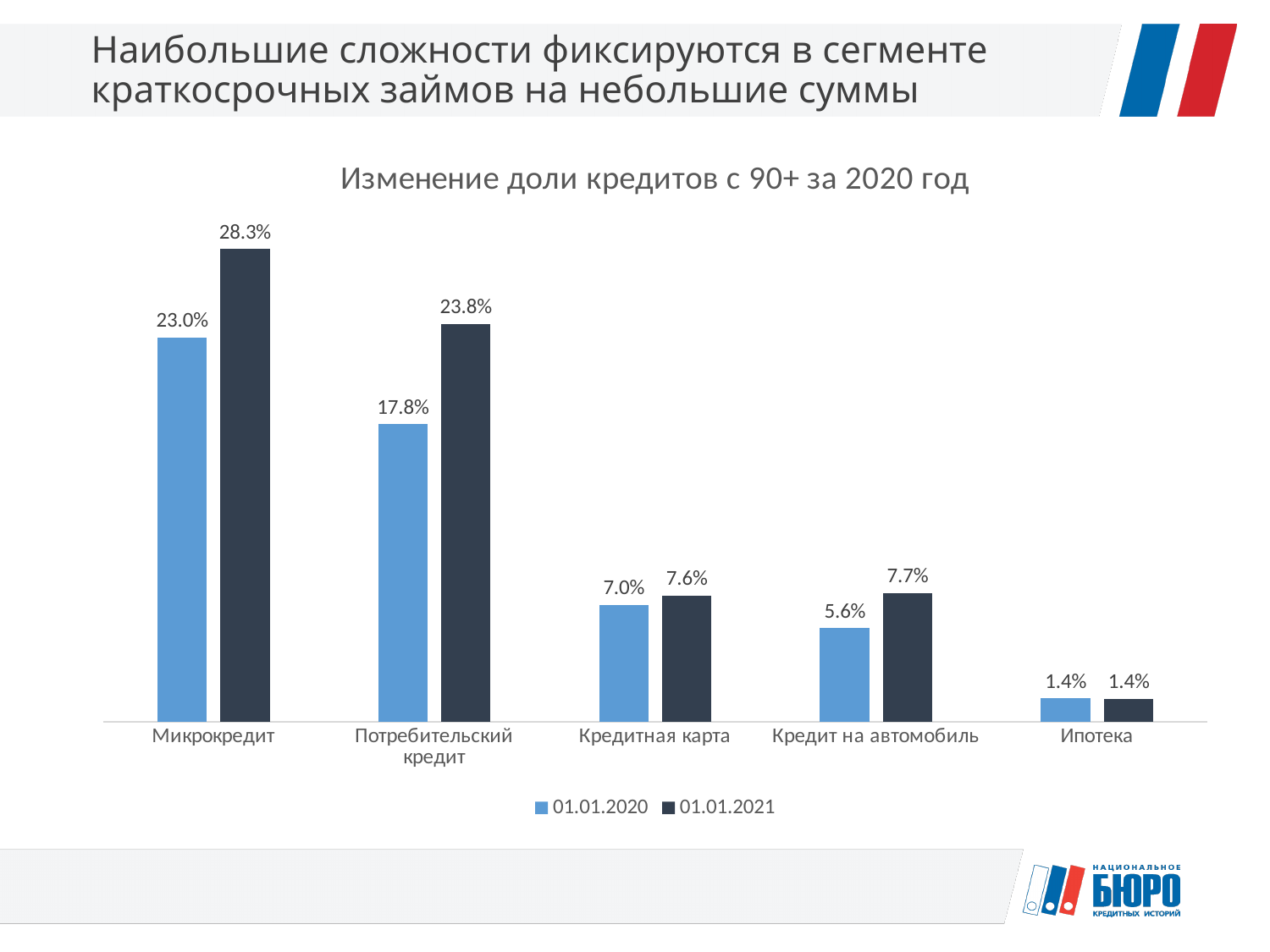
What kind of chart is shown on the slide? Bar chart How many series does the legend list? 2 What is the title of the chart? Изменение доли кредитов с 90+ за 2020 год Which is larger for Кредитная карта: the 01.01.2020 value or the 01.01.2021 value? 01.01.2021 How many categories are shown on the x axis? 5 What is the value for Кредит на автомобиль in the 01.01.2021 series? 7.7% What is the difference between the 01.01.2021 and 01.01.2020 values for Микрокредит? 5.3% What is the value for Потребительский кредит in the 01.01.2020 series? 17.8% Which category has the lowest value in the 01.01.2021 series? Ипотека What is the difference between the 01.01.2021 and 01.01.2020 values for Потребительский кредит? 6.0% Which category has the highest value in the 01.01.2020 series? Микрокредит What is the value for Микрокредит in the 01.01.2021 series? 28.3%